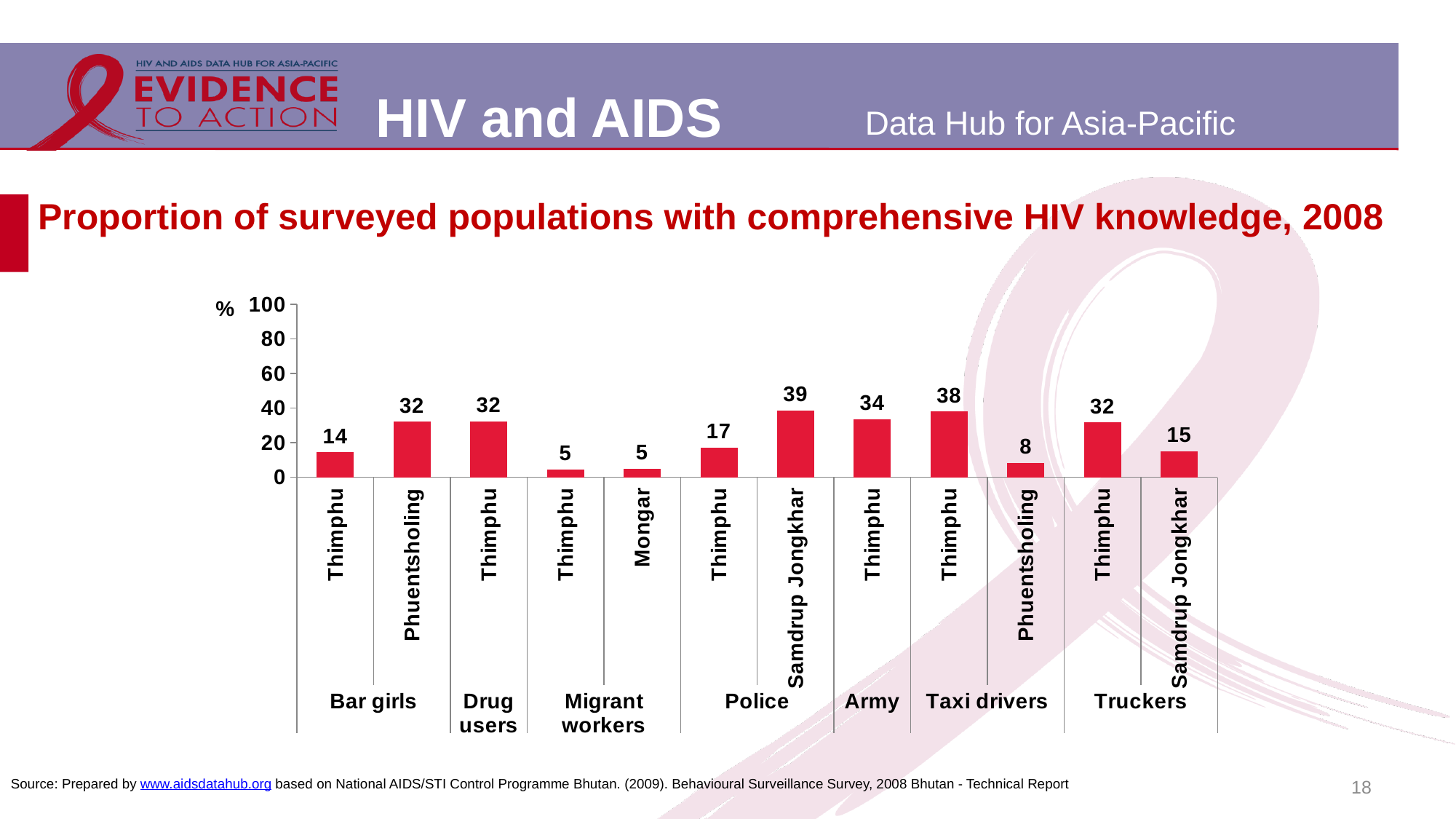
What is the title of the chart? Proportion of surveyed populations with comprehensive HIV knowledge, 2008 What is the difference between the Army value in Thimphu and the Bar girls value in Thimphu? 20 What is the value for Truckers in Samdrup Jongkhar? 15 What is the lowest value shown on the chart? 5 What kind of chart is shown? Bar chart What is the value for Taxi drivers in Phuentsholing? 8 What is the value for Police in Samdrup Jongkhar? 39 How many bars are plotted on the chart? 12 Which is larger: the Taxi drivers value in Thimphu or the Truckers value in Thimphu? Taxi drivers in Thimphu Which bar has the highest value? Police, Samdrup Jongkhar What is the value for Bar girls in Phuentsholing? 32 Is the value for Police in Thimphu greater or less than 20? less